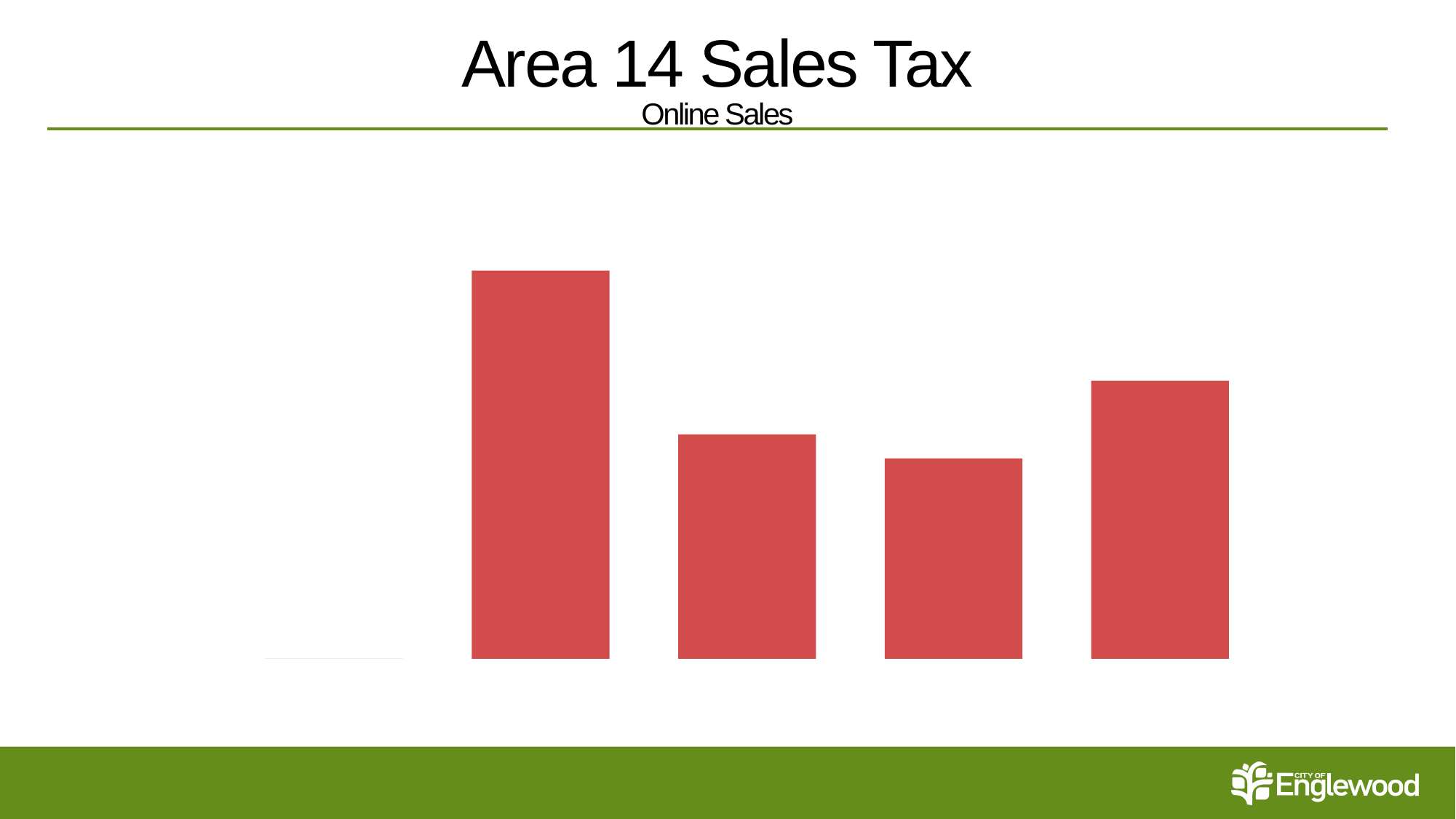
Is the second red bar from the left taller or shorter than the third red bar from the left? taller What is the title of the slide containing the chart? Area 14 Sales Tax Which of the four red bars is the shortest? the third red bar from the left What kind of chart is shown on the slide? bar chart Do the bar heights rise or fall from the first red bar to the third red bar? fall Is the rightmost red bar taller or shorter than the second red bar from the left? taller What subtitle appears under the chart's main title? Online Sales Is the leftmost red bar taller or shorter than the rightmost red bar? taller Which of the four red bars is the tallest? the leftmost red bar Does the bar height rise or fall from the third red bar to the fourth red bar? rise